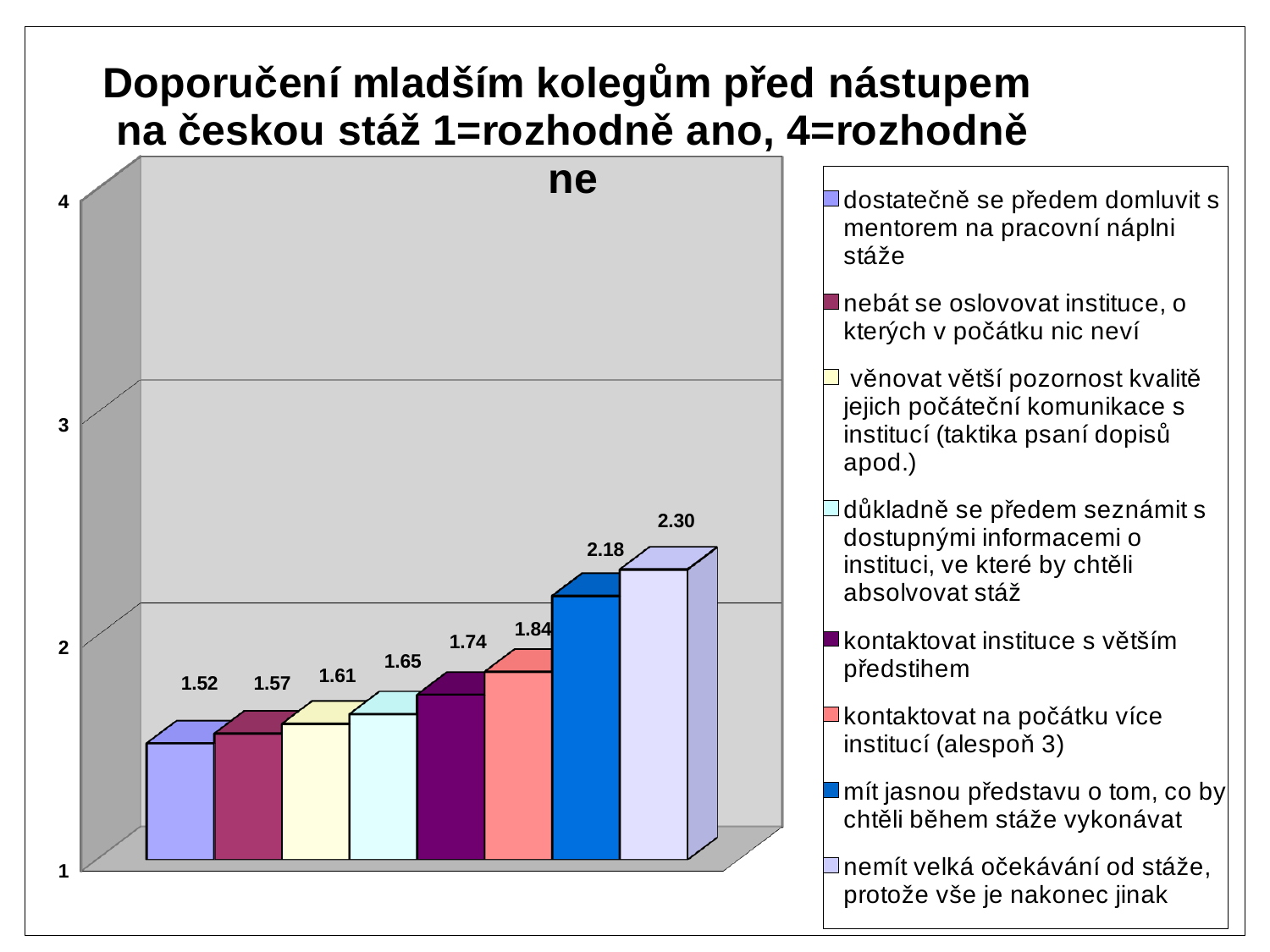
What is the value for "nemít velká očekávání od stáže, protože vše je nakonec jinak"? 2.30 Which is larger: the value for "kontaktovat instituce s větším předstihem" or the value for "mít jasnou představu o tom, co by chtěli během stáže vykonávat"? mít jasnou představu o tom, co by chtěli během stáže vykonávat Which legend entry has the lowest value? dostatečně se předem domluvit s mentorem na pracovní náplni stáže What is the difference between the highest value (2.30) and the lowest value (1.52)? 0.78 Which legend entry has the highest value? nemít velká očekávání od stáže, protože vše je nakonec jinak What kind of chart is shown on the slide? bar chart What is the value for "kontaktovat na počátku více institucí (alespoň 3)"? 1.84 How many entries does the legend list? 8 How many bars are plotted in the chart? 8 What is the value for "mít jasnou představu o tom, co by chtěli během stáže vykonávat"? 2.18 Is the value for "nebát se oslovovat instituce, o kterých v počátku nic neví" greater or less than 2? less What is the value for "dostatečně se předem domluvit s mentorem na pracovní náplni stáže"? 1.52